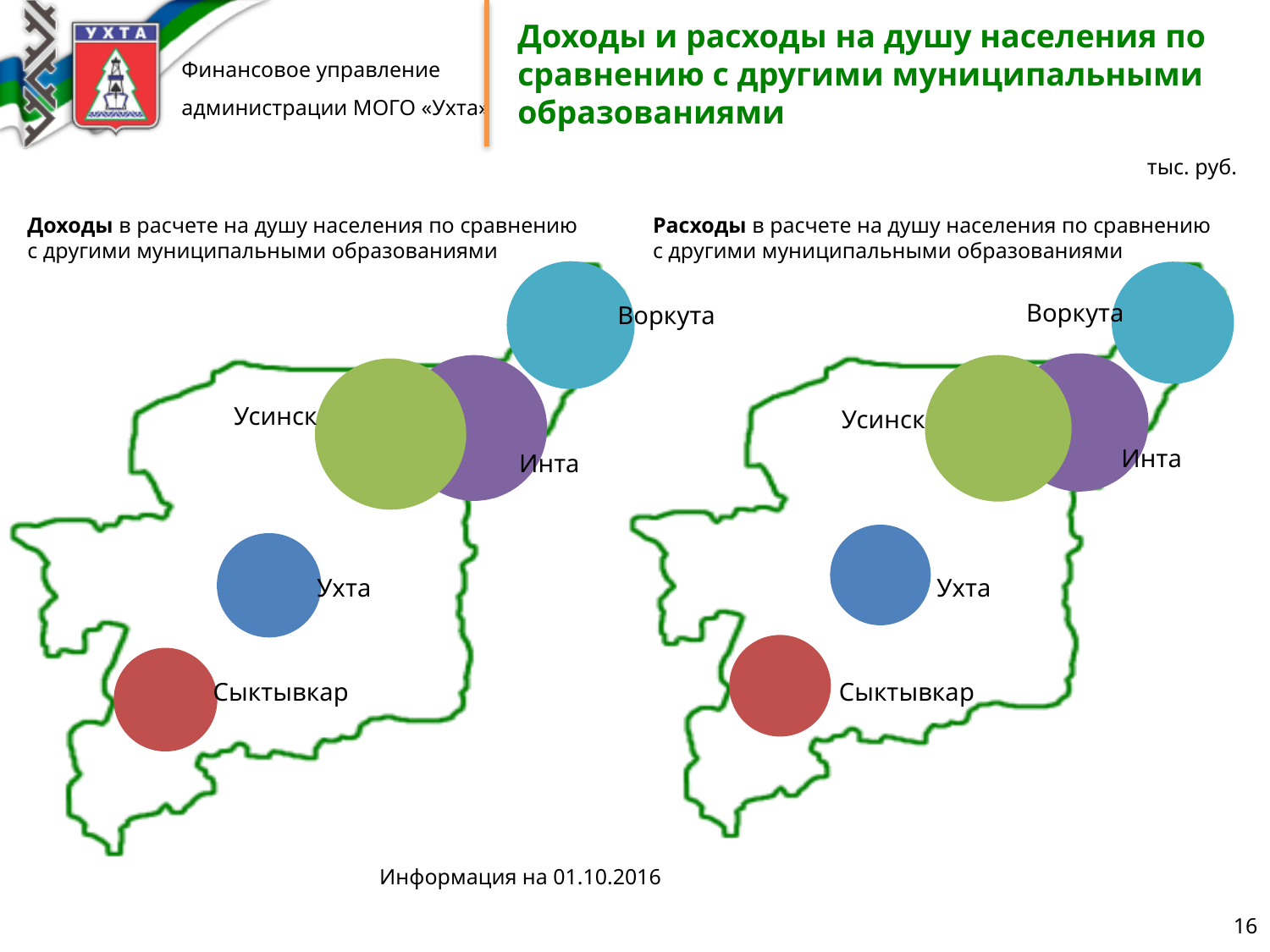
On the left chart (Доходы), which bubble is larger: Усинск or Ухта? Усинск How many municipalities are shown as bubbles on the left chart (Доходы в расчете на душу населения)? 5 How many municipalities are shown as bubbles on the right chart (Расходы в расчете на душу населения)? 5 On the left chart (Доходы), which bubble is larger: Воркута or Ухта? Воркута What kind of chart is used on the left (Доходы) side of the slide? Bubble chart On the right chart (Расходы), which bubble is larger: Инта or Ухта? Инта What unit of measurement is stated for the charts on the slide? тыс. руб. What colour is the bubble for Ухта on both charts? Blue